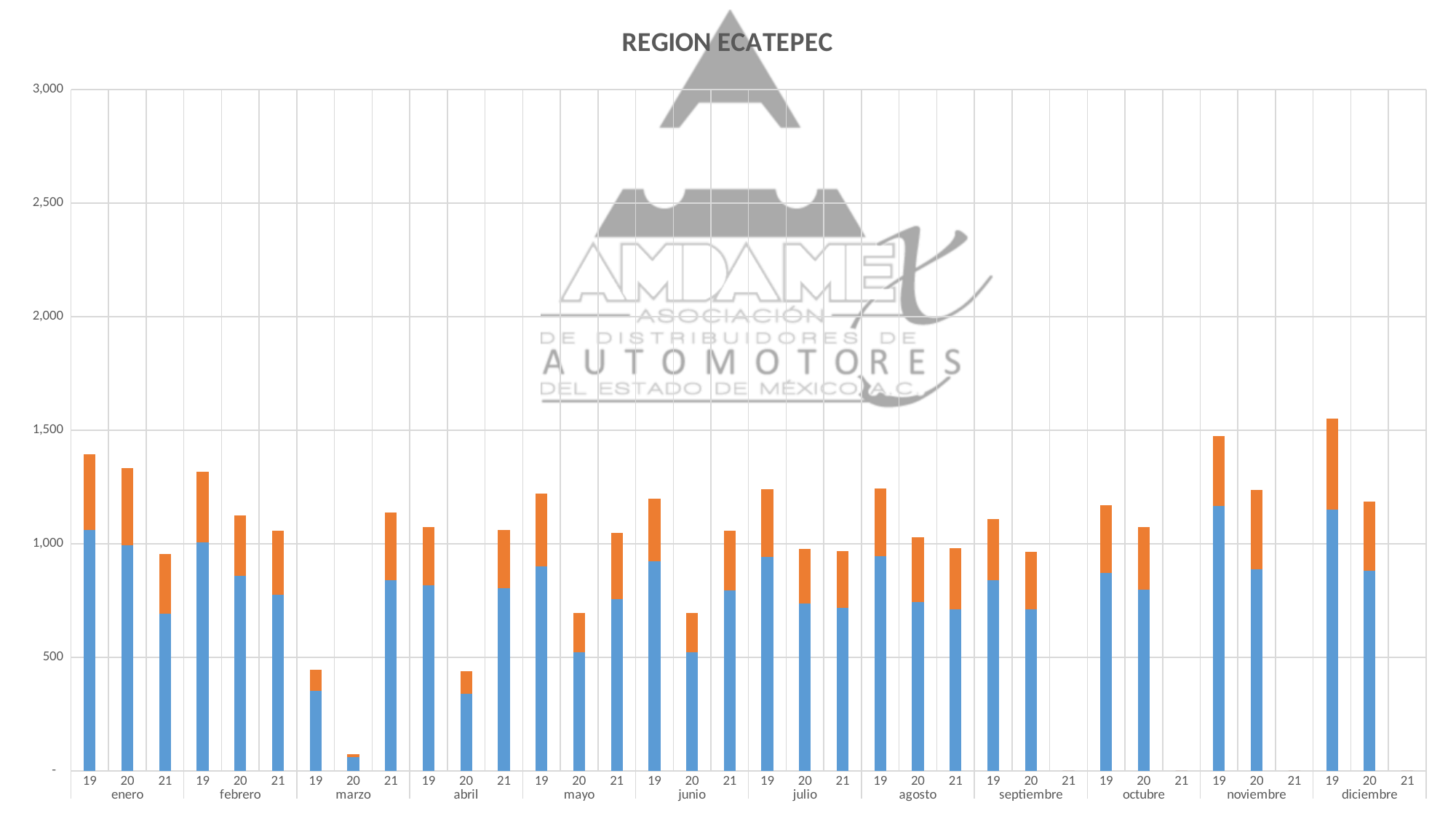
What is the title of the chart? REGION ECATEPEC Which bar is taller, marzo 20 or marzo 21? marzo 21 How many months are shown along the x axis of the chart? 12 Is the total value for marzo 19 greater or less than 500? less Is the total value for junio 20 greater or less than 500? greater Is the total value for enero 19 greater or less than 1,000? greater Which bar is the tallest in the chart? diciembre 19 What two colours are used for the stacked segments of the bars? Blue and orange Which bar is taller, enero 19 or enero 21? enero 19 Which bar is the shortest in the chart? marzo 20 What kind of chart is shown on the slide? Stacked bar chart